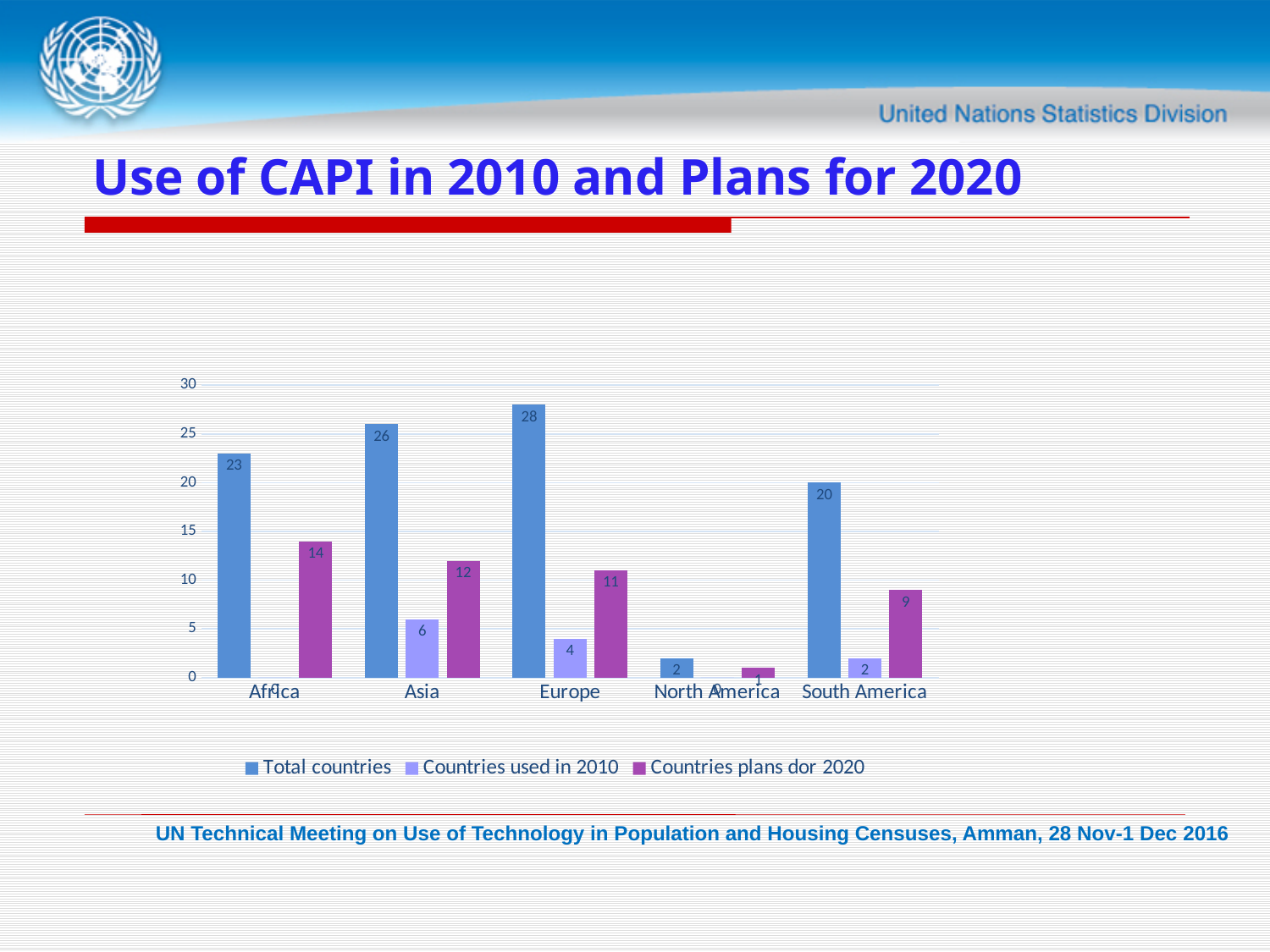
What is the value of Countries plans dor 2020 for Africa? 14 What type of chart is shown on the slide? bar chart How many series does the legend list? 3 Is the value of Total countries for Asia greater or less than 25? greater Which is larger for Asia: Countries used in 2010 or Countries plans dor 2020? Countries plans dor 2020 Which region has the highest value for Total countries? Europe How many regions are shown on the x axis? 5 What is the value of Total countries for Europe? 28 What is the value of Countries used in 2010 for Asia? 6 What is the title of the slide containing the chart? Use of CAPI in 2010 and Plans for 2020 Which region has the lowest value for Total countries? North America What is the difference between Total countries and Countries plans dor 2020 for South America? 11